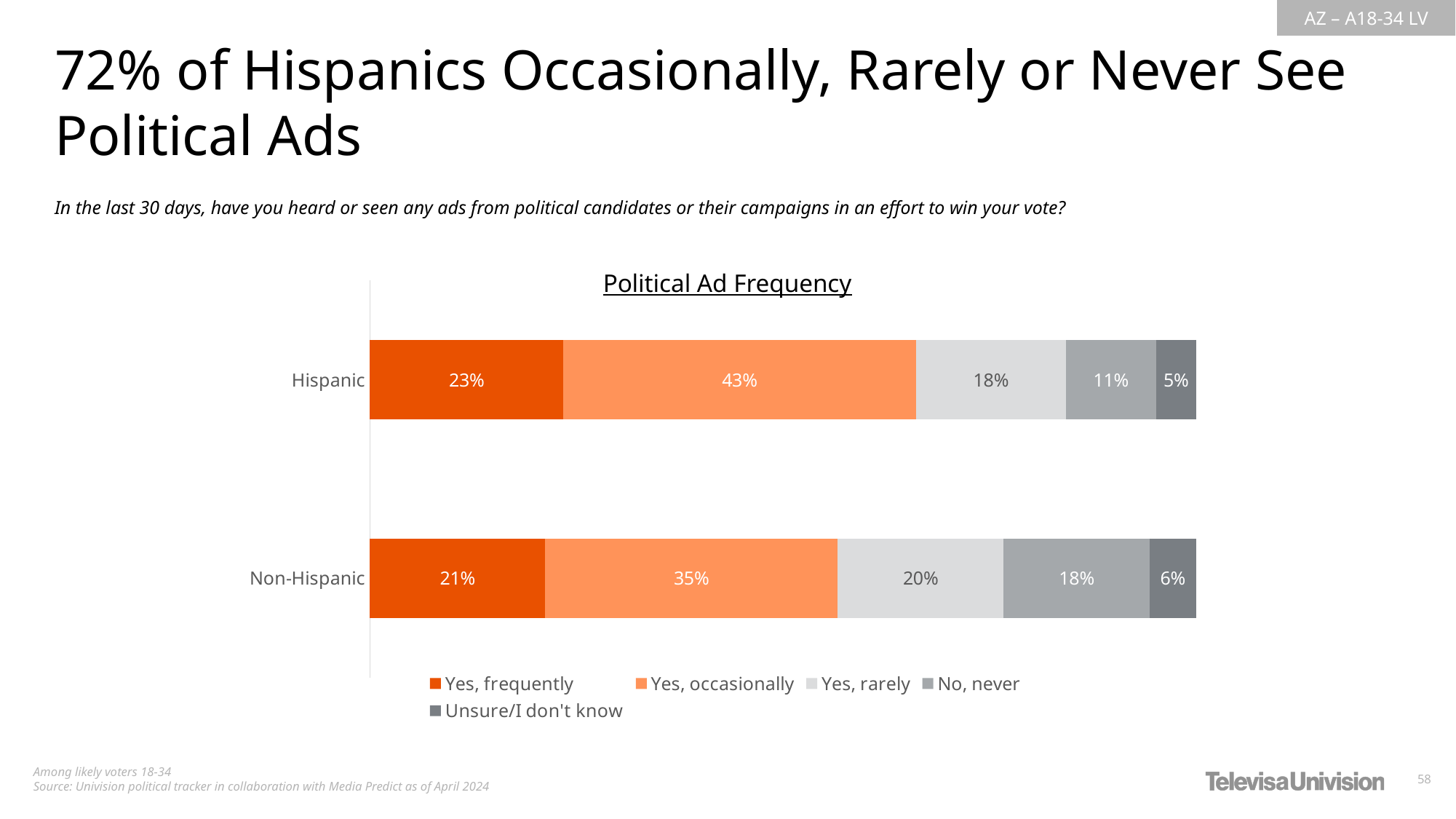
Which response category has the lowest value for Non-Hispanic respondents? Unsure/I don't know What type of chart is shown on the slide? Stacked bar chart What is the title of the chart? Political Ad Frequency Which group has the larger 'No, never' value, Hispanic or Non-Hispanic? Non-Hispanic How many series does the legend list? 5 How many groups (bars) are shown in the chart? 2 What percentage of Hispanic respondents said they see political ads 'Yes, occasionally'? 43% What is the difference between the 'Yes, occasionally' values for Hispanic and Non-Hispanic respondents? 8 percentage points Which response category has the highest value for Hispanic respondents? Yes, occasionally What is the 'Yes, frequently' value for Non-Hispanic respondents? 21% What is the 'No, never' value for Non-Hispanic respondents? 18% What is the 'Unsure/I don't know' value for Hispanic respondents? 5%